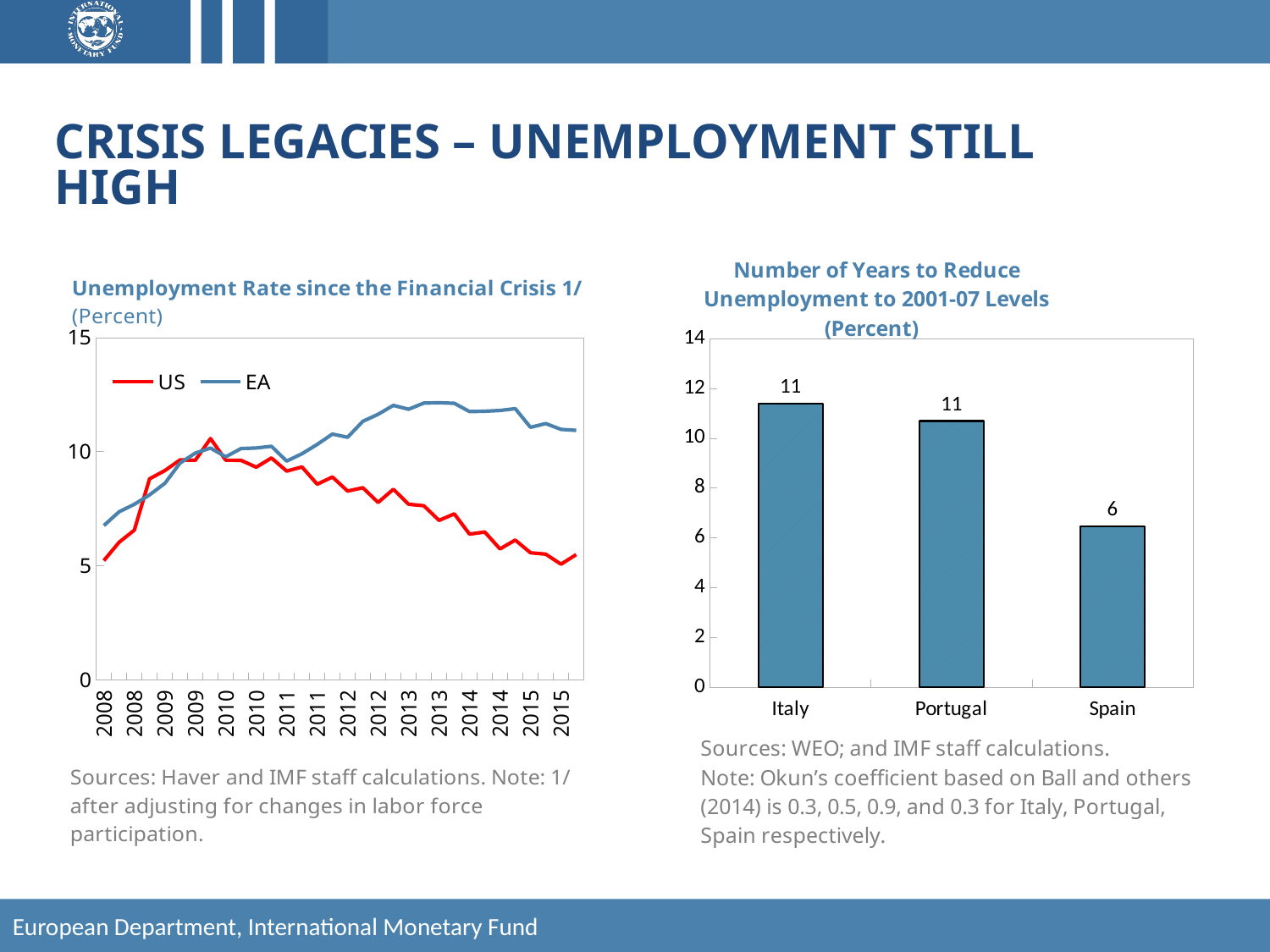
On the 'Unemployment Rate since the Financial Crisis' chart, is the EA value at the end of 2015 greater or less than 10? greater On the 'Number of Years to Reduce Unemployment to 2001-07 Levels' chart, what is the value for Italy? 11 What kind of chart is the 'Number of Years to Reduce Unemployment to 2001-07 Levels' chart? Bar chart On the 'Unemployment Rate since the Financial Crisis' chart, does the US unemployment rate rise or fall from 2010 to 2015? Fall On the 'Number of Years to Reduce Unemployment to 2001-07 Levels' chart, what is the difference between the values for Italy and Spain? 5 On the 'Number of Years to Reduce Unemployment to 2001-07 Levels' chart, which country has the lowest value? Spain On the 'Number of Years to Reduce Unemployment to 2001-07 Levels' chart, what is the value for Portugal? 11 How many series does the legend of the 'Unemployment Rate since the Financial Crisis' chart list? 2 How many countries are shown on the 'Number of Years to Reduce Unemployment to 2001-07 Levels' chart? 3 On the 'Number of Years to Reduce Unemployment to 2001-07 Levels' chart, which is larger, the value for Portugal or the value for Spain? Portugal What kind of chart is the 'Unemployment Rate since the Financial Crisis' chart? Line chart On the 'Number of Years to Reduce Unemployment to 2001-07 Levels' chart, what is the value for Spain? 6